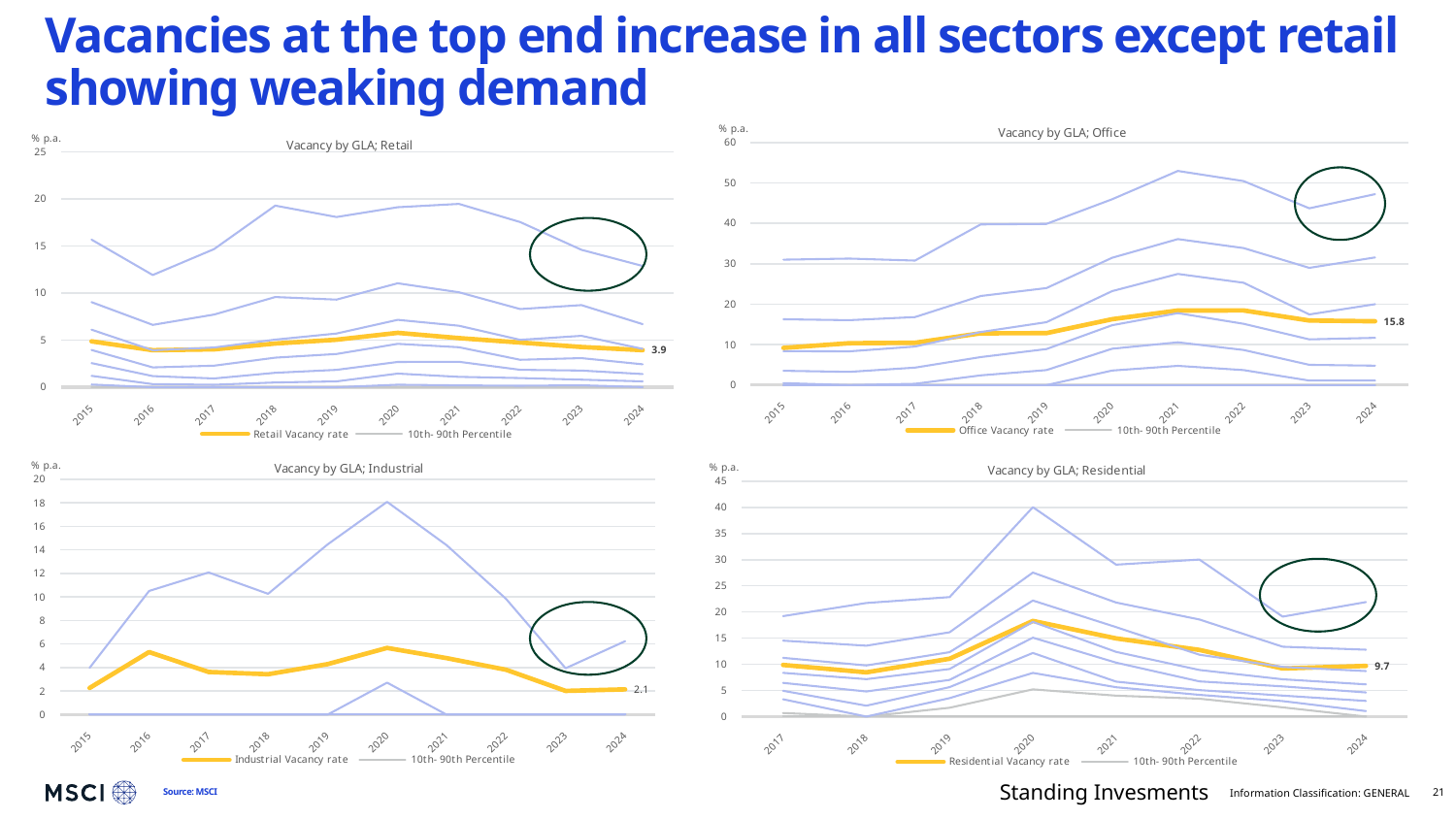
How many series does the legend of the 'Vacancy by GLA; Industrial' chart list? 2 How many years are shown on the x axis of the 'Vacancy by GLA; Residential' chart? 8 On the 'Vacancy by GLA; Residential' chart, what is the residential vacancy rate labelled for 2024? 9.7 Which is larger in 2024: the office vacancy rate on the Office chart or the retail vacancy rate on the Retail chart? Office vacancy rate What is the difference between the 2024 office vacancy rate (15.8) and the 2024 retail vacancy rate (3.9)? 11.9 On the 'Vacancy by GLA; Office' chart, what is the office vacancy rate labelled for 2024? 15.8 How many years are shown on the x axis of the 'Vacancy by GLA; Retail' chart? 10 On the 'Vacancy by GLA; Industrial' chart, is the industrial vacancy rate for 2016 greater or less than 4? greater On the 'Vacancy by GLA; Retail' chart, what is the retail vacancy rate labelled for 2024? 3.9 On the 'Vacancy by GLA; Residential' chart, in which year is the residential vacancy rate highest? 2020 On the 'Vacancy by GLA; Industrial' chart, what is the industrial vacancy rate labelled for 2024? 2.1 What kind of chart is 'Vacancy by GLA; Office'? Line chart